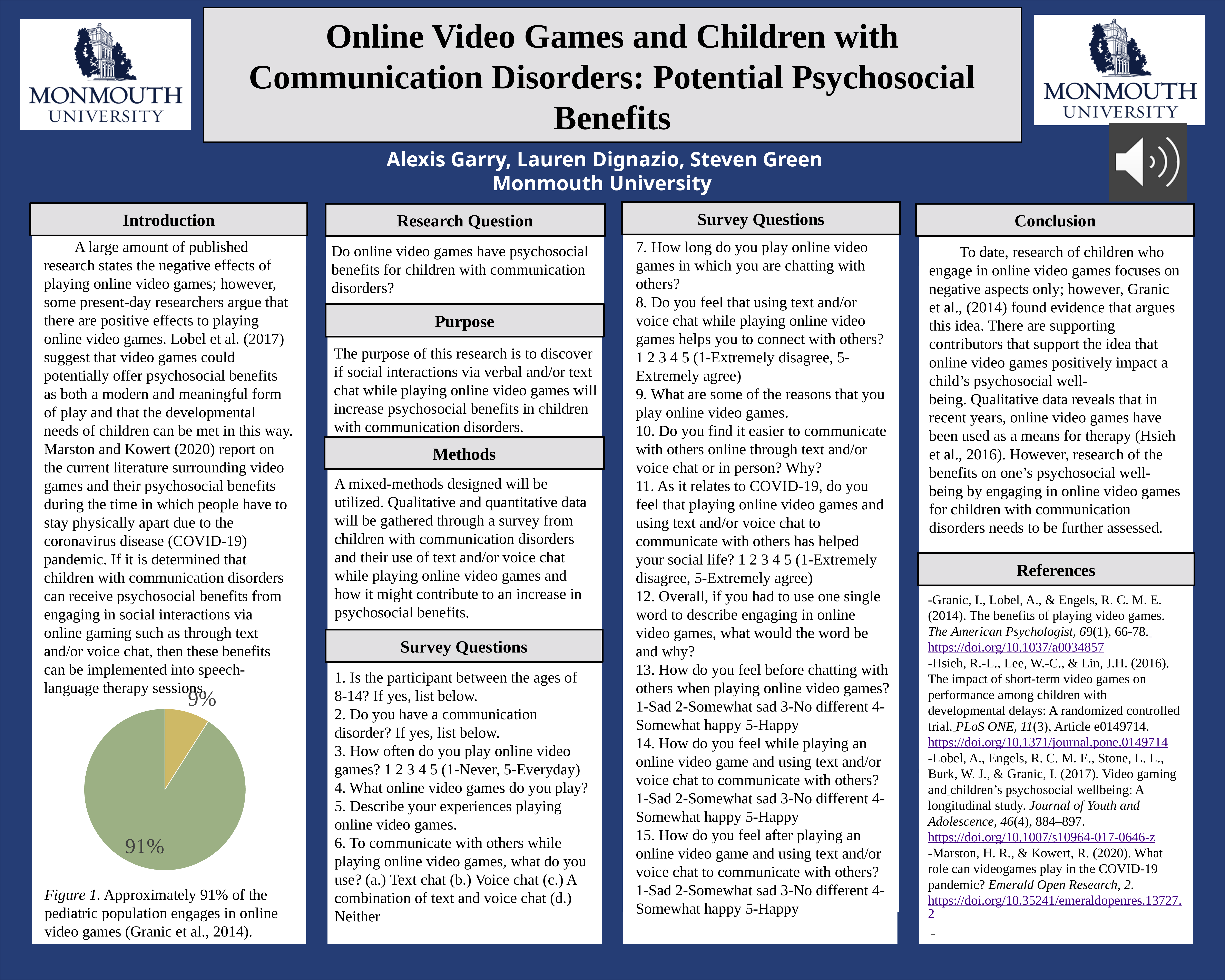
How many slices does the pie chart on the slide have? 2 What is the difference between the two slice values in the pie chart? 82% What is the figure number given in the caption below the pie chart? Figure 1 Which slice of the pie chart is larger, the green one or the gold one? the green one According to the figure caption, what share of the pediatric population engages in online video games? 91% What percentage is shown on the smallest slice of the pie chart? 9% Is the value of the green slice in the pie chart greater or less than 50%? greater What percentage is shown on the largest slice of the pie chart? 91% What value is labelled on the green slice of the pie chart? 91% What do the two slice values in the pie chart add up to? 100% What value is labelled on the gold slice of the pie chart? 9% What kind of chart is shown in the Introduction section of the slide? pie chart